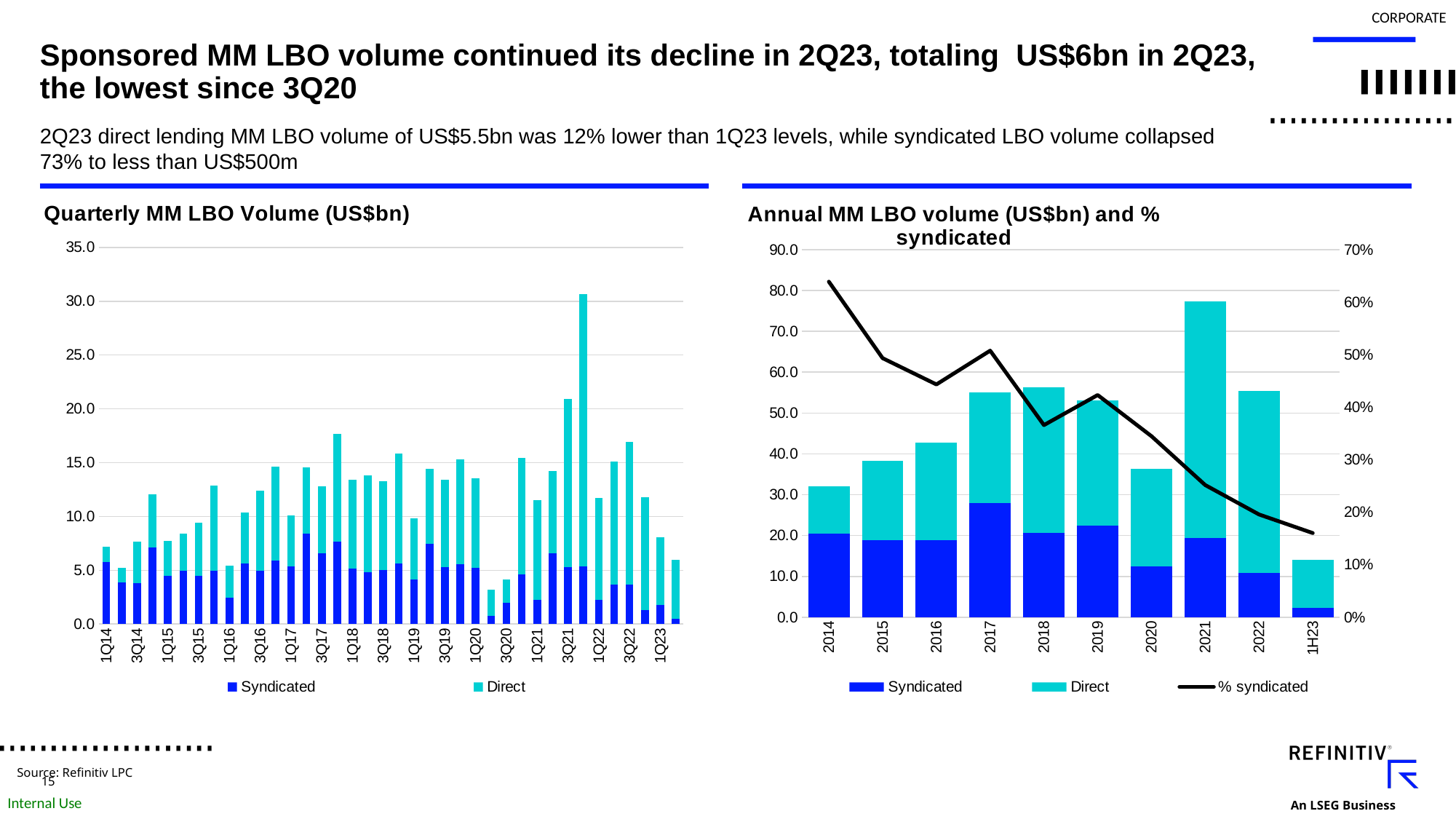
In the 'Annual MM LBO volume (US$bn) and % syndicated' chart, which period has the lowest total bar? 1H23 How many series does the legend of the 'Quarterly MM LBO Volume (US$bn)' chart list? 2 In the 'Annual MM LBO volume (US$bn) and % syndicated' chart, is the total bar for 1H23 greater or less than 20.0? less What kind of chart is the 'Quarterly MM LBO Volume (US$bn)' chart on the left? Stacked bar chart In the 'Annual MM LBO volume (US$bn) and % syndicated' chart, does the % syndicated line generally rise or fall from 2014 to 1H23? fall In the 'Annual MM LBO volume (US$bn) and % syndicated' chart, which year has the larger Syndicated bar, 2017 or 2022? 2017 In the 'Quarterly MM LBO Volume (US$bn)' chart, is the total bar for 3Q20 greater or less than 5.0? less How many years (categories) are shown on the x axis of the 'Annual MM LBO volume (US$bn) and % syndicated' chart? 10 How many series does the legend of the 'Annual MM LBO volume (US$bn) and % syndicated' chart list? 3 In the 'Annual MM LBO volume (US$bn) and % syndicated' chart, is the total bar for 2021 greater or less than 70.0? greater In the 'Annual MM LBO volume (US$bn) and % syndicated' chart, which year has the tallest total bar? 2021